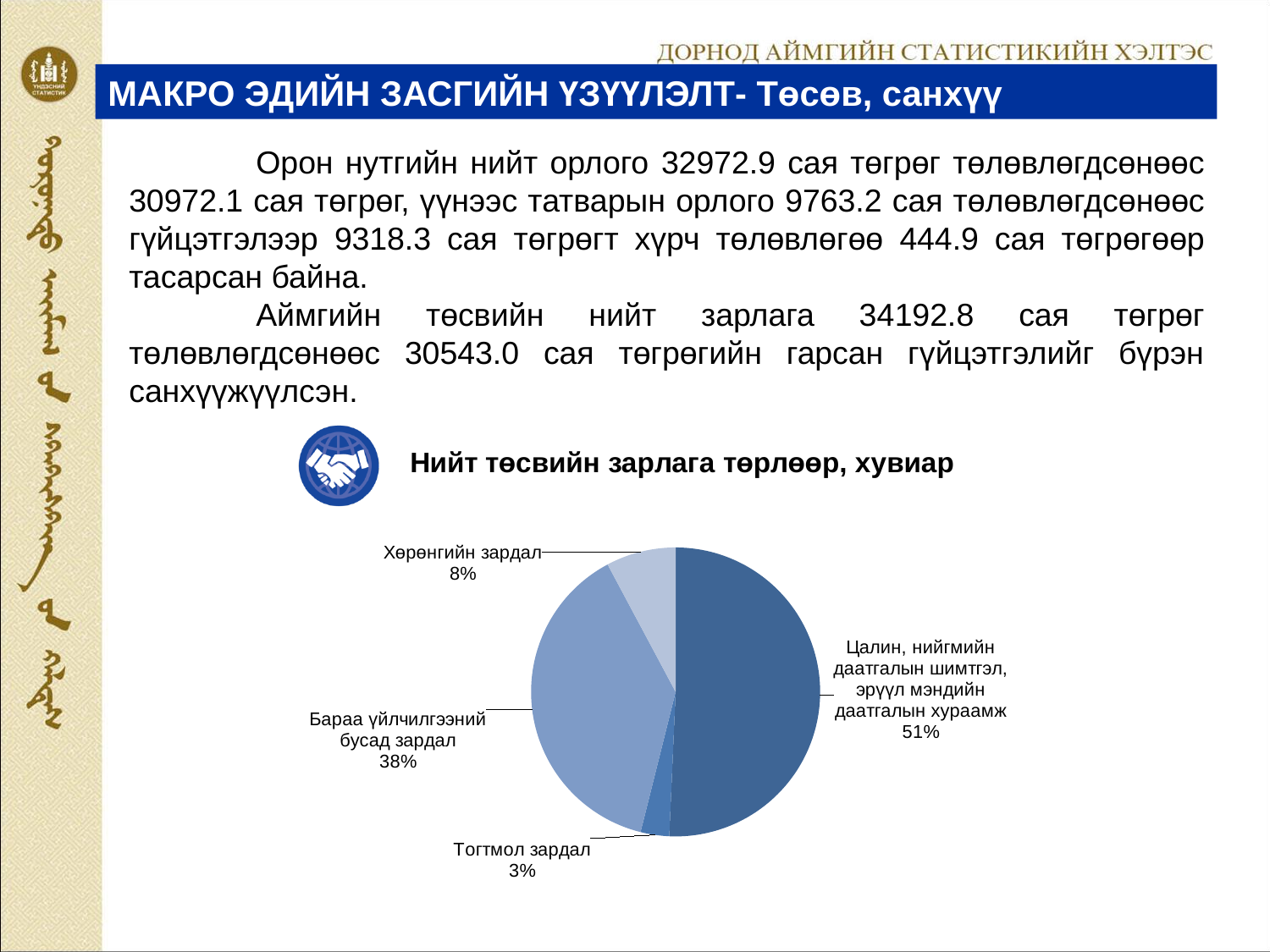
What share of the pie is labelled "Цалин, нийгмийн даатгалын шимтгэл, эрүүл мэндийн даатгалын хураамж"? 51% What is the combined share of "Хөрөнгийн зардал" and "Тогтмол зардал"? 11% What kind of chart is shown on the slide? Pie chart Which category has the smallest slice of the pie? Тогтмол зардал How many slices does the pie chart have? 4 What is the difference in percentage points between "Цалин, нийгмийн даатгалын шимтгэл, эрүүл мэндийн даатгалын хураамж" and "Бараа үйлчилгээний бусад зардал"? 13 percentage points What share of the pie is labelled "Хөрөнгийн зардал"? 8% What share of the pie is labelled "Бараа үйлчилгээний бусад зардал"? 38% What is the title of the chart on the slide? Нийт төсвийн зарлага төрлөөр, хувиар Which category has the largest slice of the pie? Цалин, нийгмийн даатгалын шимтгэл, эрүүл мэндийн даатгалын хураамж Which is larger: the share for "Хөрөнгийн зардал" or the share for "Тогтмол зардал"? Хөрөнгийн зардал